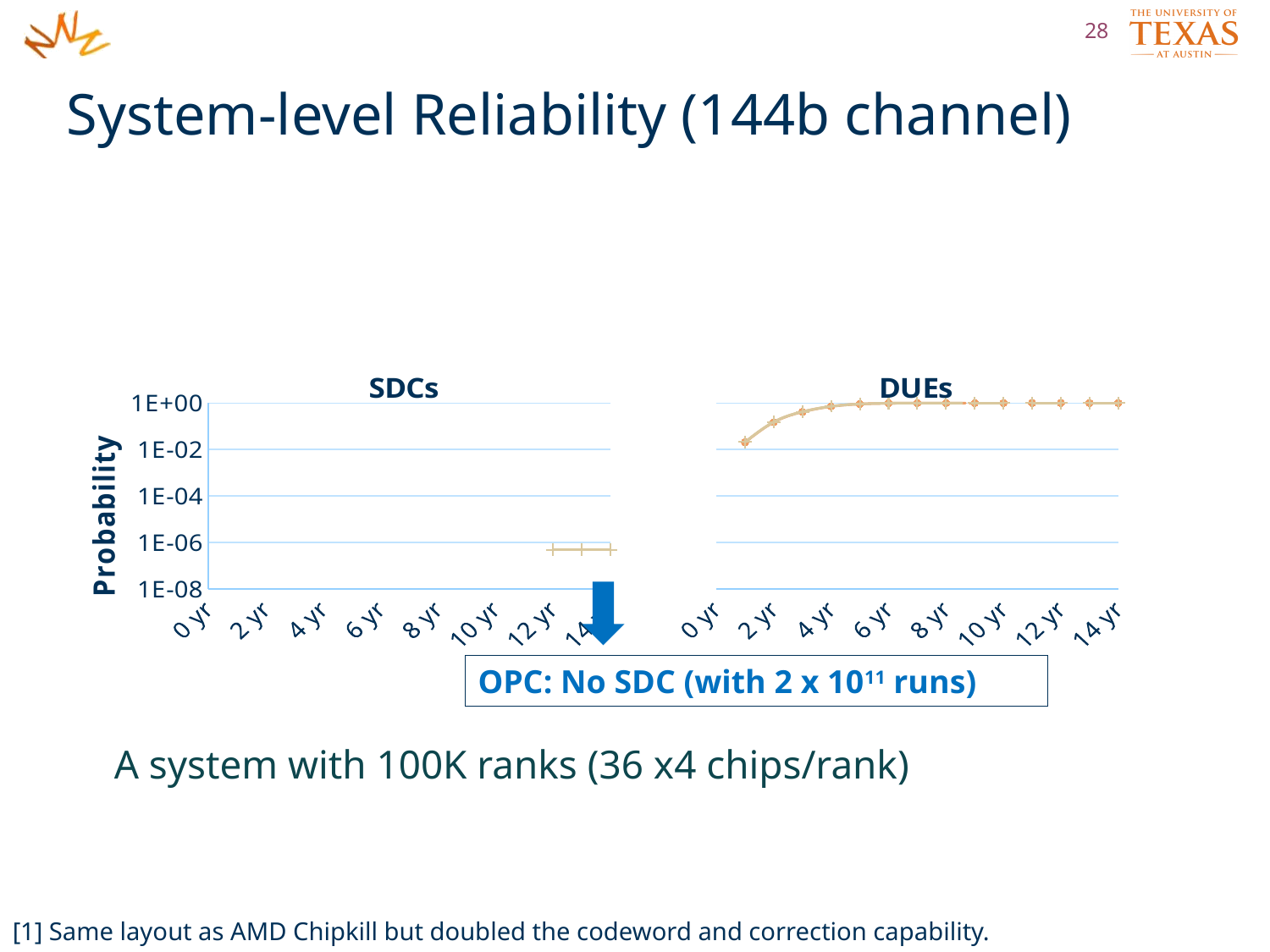
In the SDCs chart, is the plotted value near 13 yr greater or less than 1E-08? greater What is the y-axis label shared by the two charts? Probability Which is larger: the DUEs value at 10 yr or the SDCs value near 13 yr? DUEs value at 10 yr What is the title of the left chart? SDCs In the DUEs chart, is the value at 10 yr greater or less than 1E-04? greater In the DUEs chart, is the value at 2 yr greater or less than 1E-04? greater What kind of chart is the DUEs chart? line chart How many x-axis tick labels does the DUEs chart show? 8 What is the highest y-axis tick shown on the charts? 1E+00 In the DUEs chart, do the values rise or fall from 0 yr to 6 yr? rise